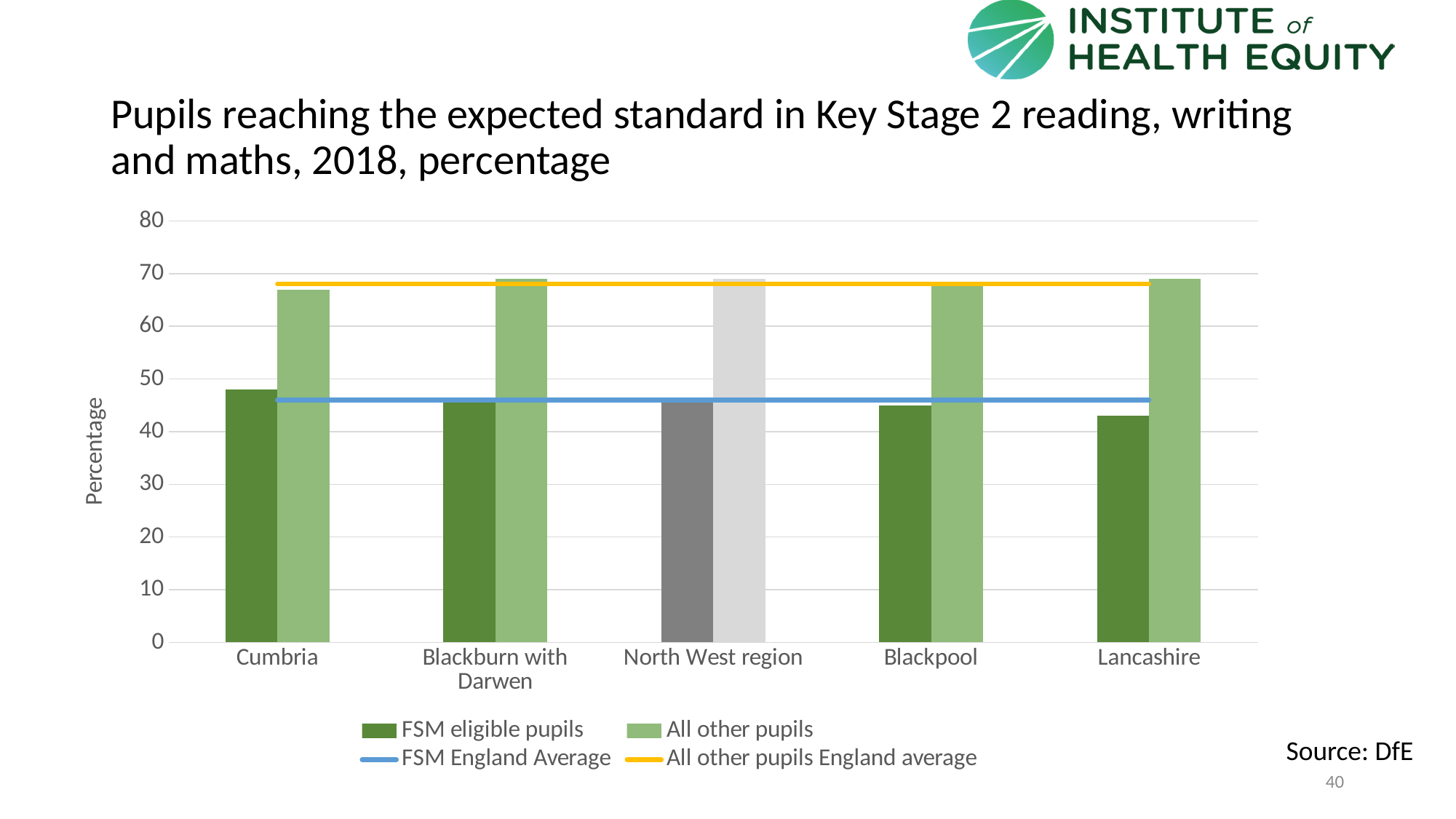
What kind of chart is shown on the slide? bar chart Is the value for All other pupils in Cumbria greater or less than 70? less Is the value for All other pupils in Lancashire greater or less than 60? greater What is the label on the chart's vertical axis? Percentage Is the value for FSM eligible pupils in Cumbria greater or less than 40? greater Which category has the lowest value for FSM eligible pupils? Lancashire How many categories are shown on the x axis of the chart? 5 Which category has the highest value for FSM eligible pupils? Cumbria Which is larger: the FSM eligible pupils value for Cumbria or for Lancashire? Cumbria How many series does the chart's legend list? 4 In Blackpool, which is larger: the value for FSM eligible pupils or for All other pupils? All other pupils